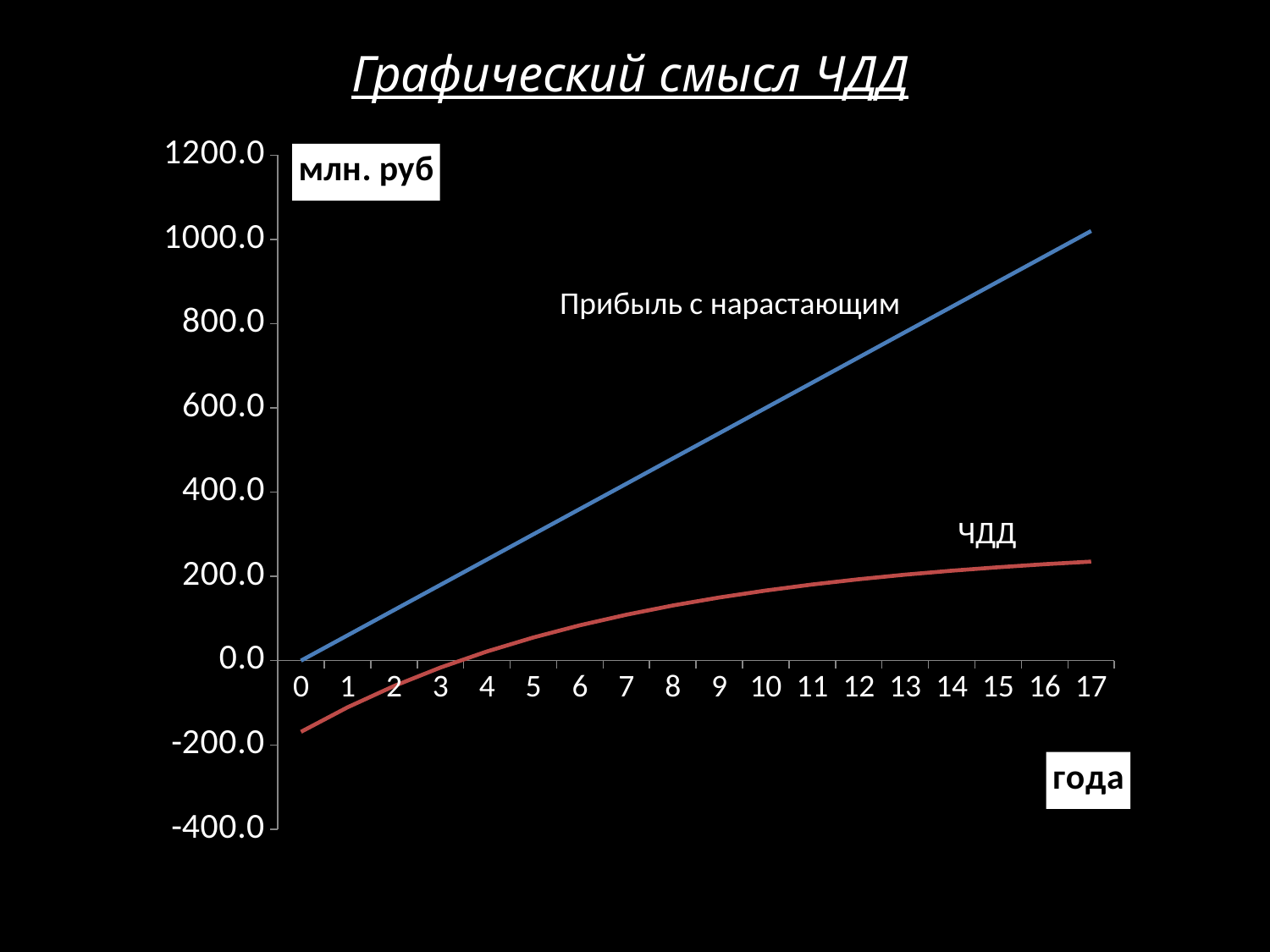
Is the value of 'ЧДД' at year 2 greater or less than 0.0? less How many series are plotted on the chart? 2 What kind of chart is shown on the slide? line chart Is the value of 'Прибыль с нарастающим' at year 17 greater or less than 800.0? greater Does the 'ЧДД' line rise or fall as the years increase? rise Is the value of 'ЧДД' at year 17 greater or less than 200.0? greater How many points are marked along the x axis (years)? 18 What unit is shown for the vertical axis? млн. руб What is the title of the slide's chart? Графический смысл ЧДД At year 10, which series has the larger value, 'Прибыль с нарастающим' or 'ЧДД'? Прибыль с нарастающим Does the 'Прибыль с нарастающим' line rise or fall as the years increase? rise